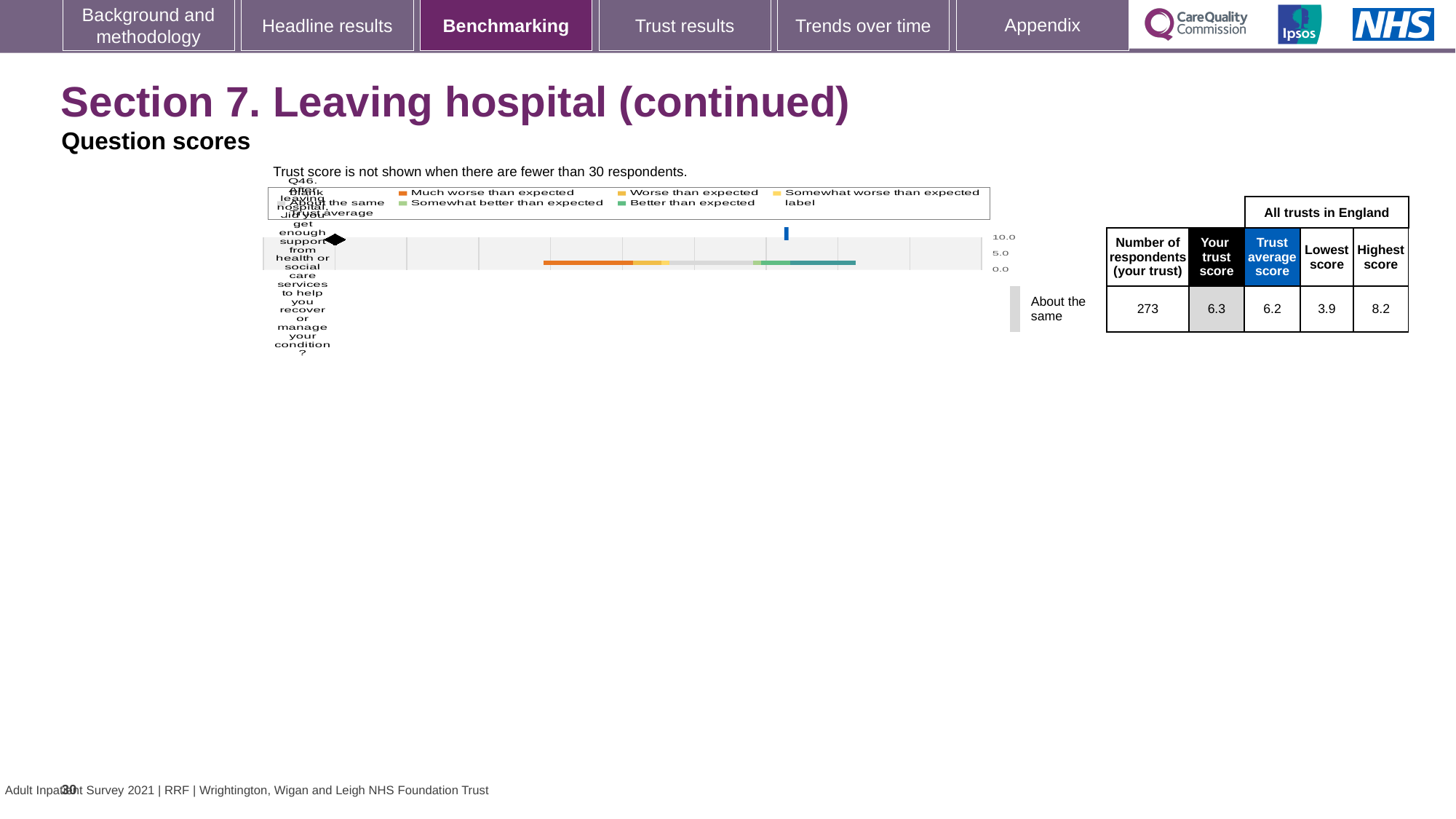
What is the maximum value shown on the score axis of the Q46 chart? 10.0 How many respondents from the trust answered Q46? 273 What is the trust average score for Q46 across all trusts in England? 6.2 Which is larger for Q46: the trust's own score or the trust average score? Your trust score What is the lowest score among all trusts in England for Q46? 3.9 What is the highest score among all trusts in England for Q46? 8.2 What is the trust's score for Q46 (support from health or social care services after leaving hospital)? 6.3 By how much does the trust's score for Q46 exceed the trust average score? 0.1 What kind of chart is used to show the Q46 benchmarking result? bar chart What is the difference between the highest and lowest scores for Q46 across all trusts in England? 4.3 Which benchmarking category does the trust's Q46 score fall into? About the same How many questions are plotted on the benchmarking chart on this slide? 1